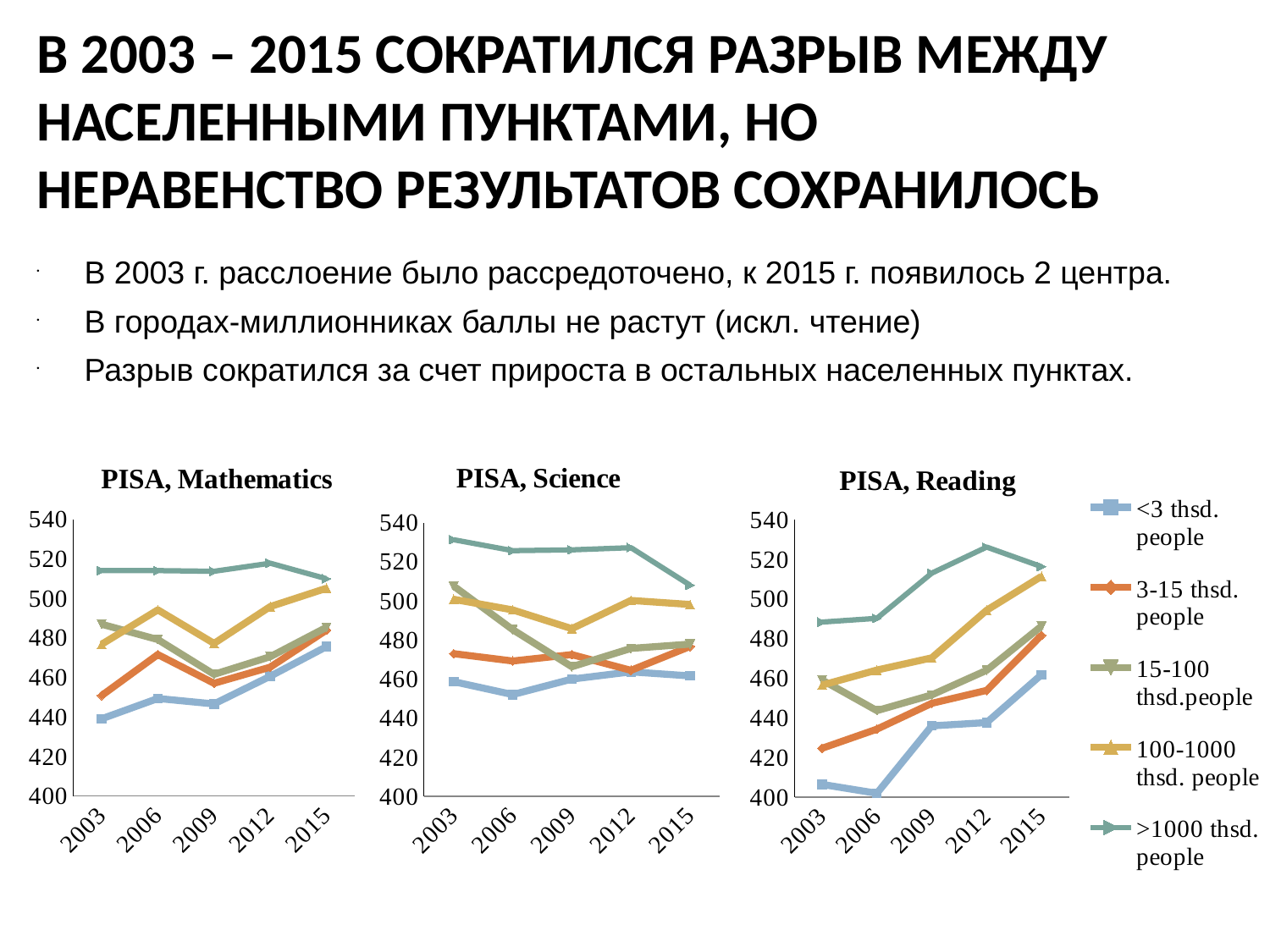
In the PISA, Reading chart, does the value for 100-1000 thsd. people rise or fall from 2003 to 2015? rise In the PISA, Mathematics chart, is the value for >1000 thsd. people in 2003 greater or less than 500? greater How many series does the legend list for the charts? 5 How many years are shown on the x axis of the PISA, Science chart? 5 In the PISA, Reading chart, is the value for <3 thsd. people in 2006 greater or less than 420? less In the PISA, Science chart, does the value for >1000 thsd. people rise or fall between 2012 and 2015? fall In the PISA, Reading chart, which series has the lowest value in 2003? <3 thsd. people What kind of chart is the PISA, Mathematics chart? line chart In the PISA, Science chart, which is larger in 2015: >1000 thsd. people or <3 thsd. people? >1000 thsd. people In the PISA, Science chart, which series has the highest value in 2003? >1000 thsd. people What is the title of the middle chart on the slide? PISA, Science In the PISA, Science chart, is the value for >1000 thsd. people in 2003 greater or less than 520? greater